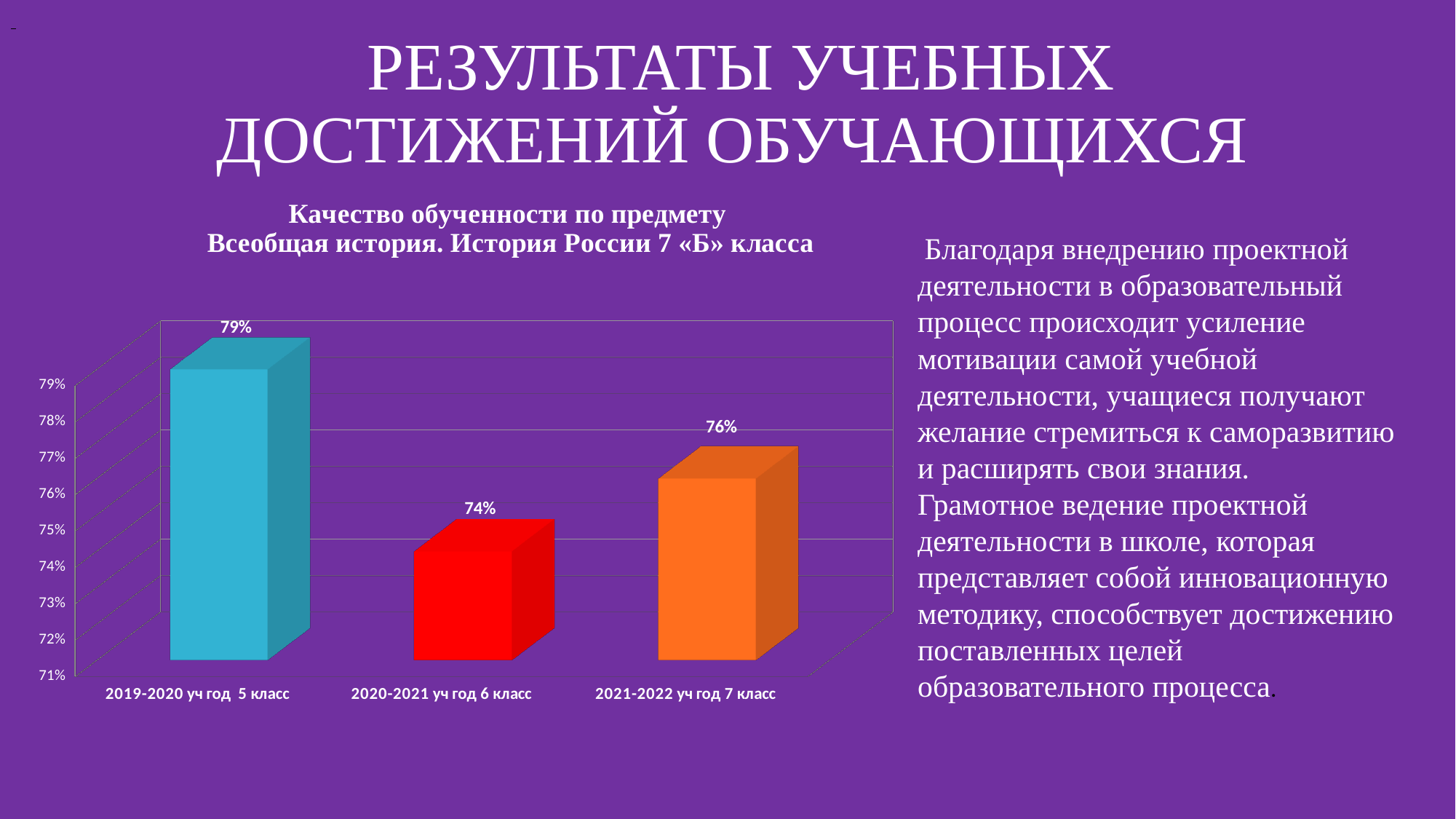
What is the title of the chart? Качество обученности по предмету Всеобщая история. История России 7 «Б» класса How many categories are shown in the chart? 3 What kind of chart is shown on the slide? bar chart Which is larger, the value for 2021-2022 уч год 7 класс or 2020-2021 уч год 6 класс? 2021-2022 уч год 7 класс What is the value for 2020-2021 уч год 6 класс? 74% What is the difference between the values for 2021-2022 уч год 7 класс and 2020-2021 уч год 6 класс? 2% What is the value for 2021-2022 уч год 7 класс? 76% Which category has the lowest value? 2020-2021 уч год 6 класс Which category has the highest value? 2019-2020 уч год 5 класс Is the value for 2020-2021 уч год 6 класс greater or less than 75%? less What is the value for 2019-2020 уч год 5 класс? 79% What is the difference between the values for 2019-2020 уч год 5 класс and 2020-2021 уч год 6 класс? 5%